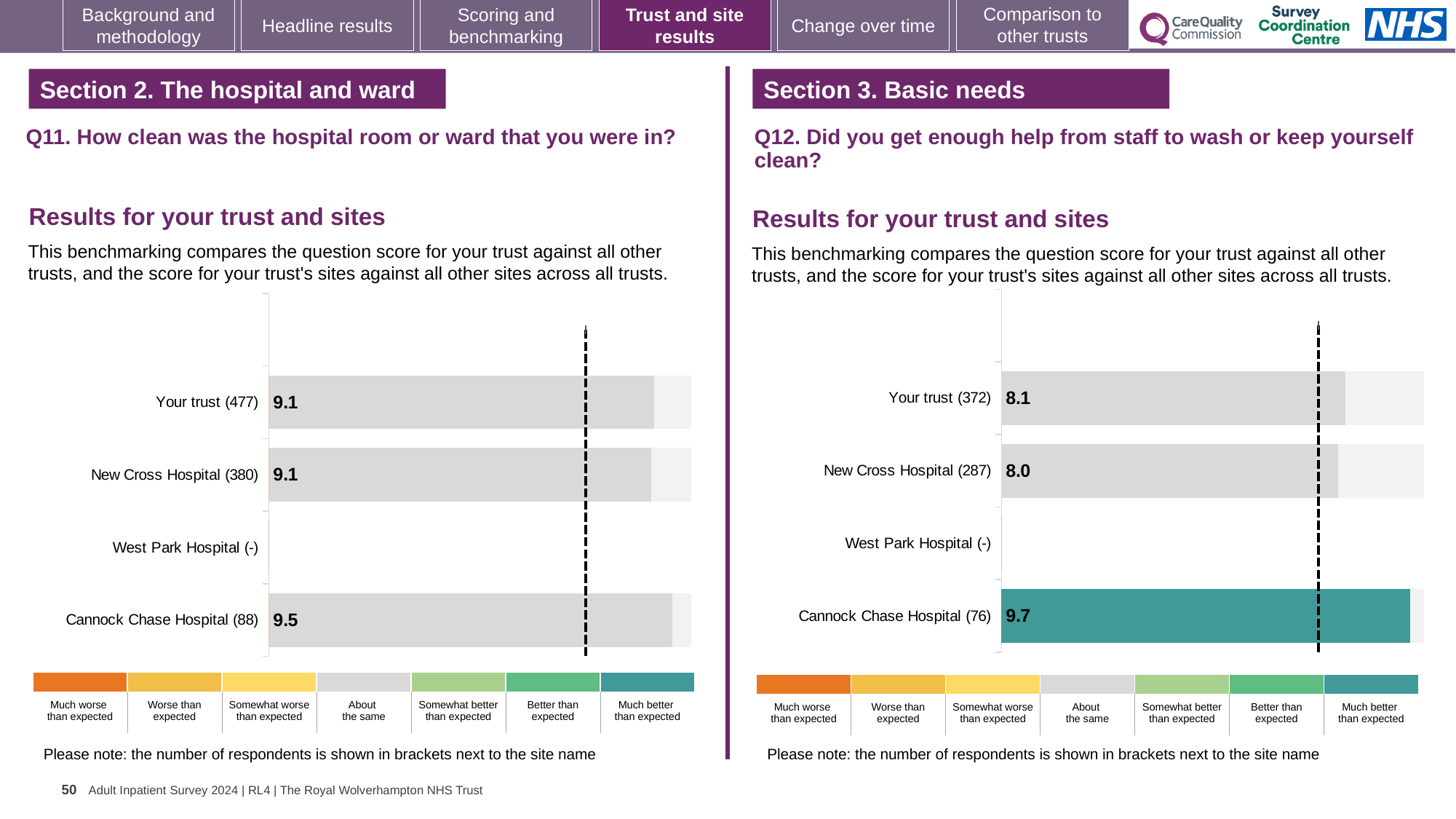
In the Q11 chart on the left, what is the score for Cannock Chase Hospital? 9.5 In the Q12 chart on the right, which site has the highest score? Cannock Chase Hospital In the Q12 chart on the right, how many respondents are shown in brackets for Your trust? 372 How many site rows are listed in the Q11 chart on the left? 4 What kind of chart is used in the Q11 chart on the left? Bar chart In the Q12 chart on the right, what is the score for Cannock Chase Hospital? 9.7 In the Q12 chart on the right, which site has the lowest score among those with a score shown? New Cross Hospital In the Q11 chart on the left, what is the score for Your trust? 9.1 In the Q12 chart on the right, what is the difference between the scores for Cannock Chase Hospital and Your trust? 1.6 In the Q12 chart on the right, which has the larger score, Your trust or Cannock Chase Hospital? Cannock Chase Hospital In the Q12 chart on the right, what is the score for New Cross Hospital? 8.0 In the Q11 chart on the left, what is the difference between the scores for Cannock Chase Hospital and New Cross Hospital? 0.4